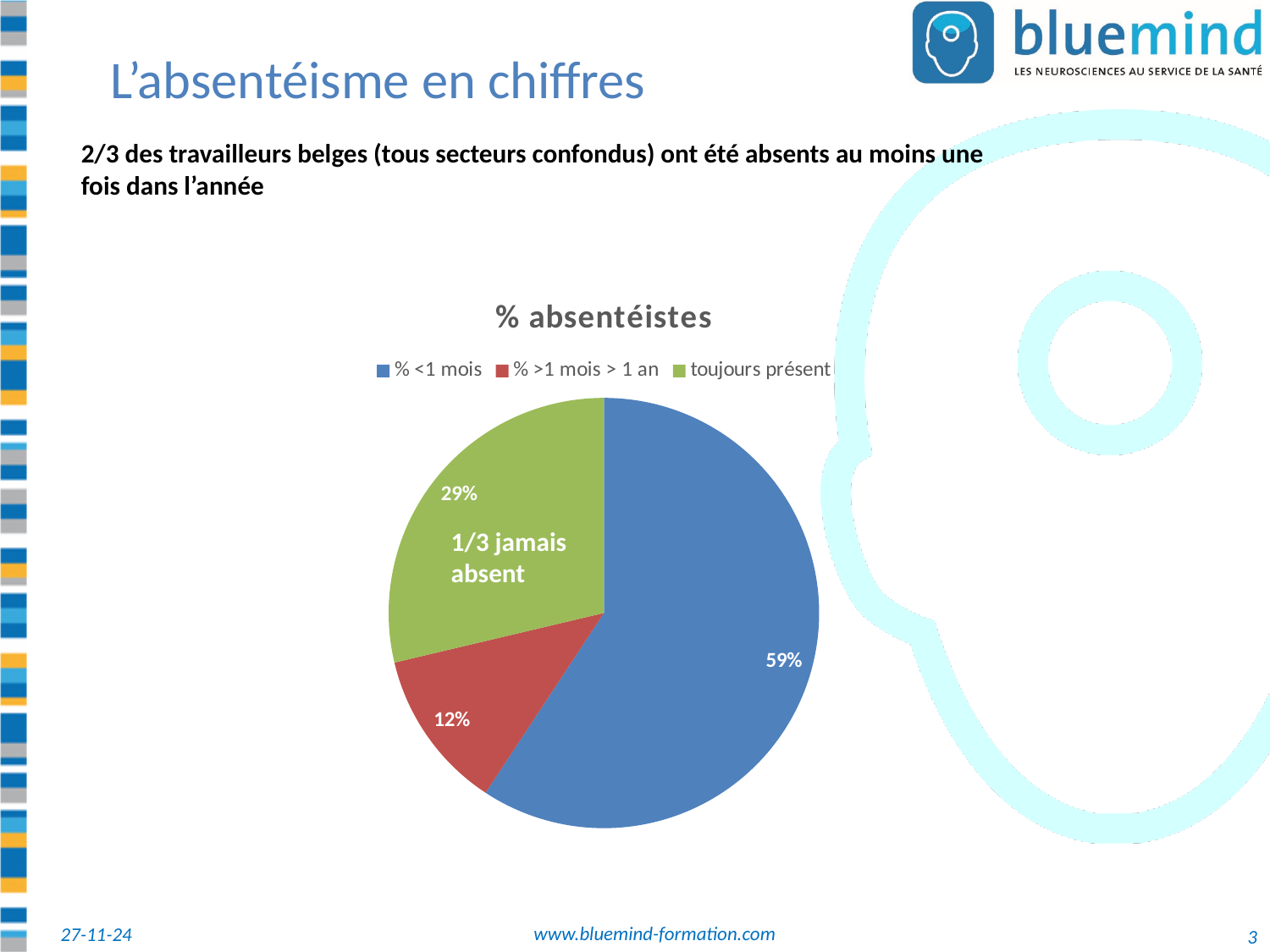
What is the title of the chart? % absentéistes What share of the pie does the "% >1 mois > 1 an" slice represent? 12% What share of the pie does the "toujours présent" slice represent? 29% How many entries does the legend list? 3 Which is larger, the "toujours présent" slice or the "% >1 mois > 1 an" slice? toujours présent What kind of chart is shown on the slide? pie chart How many slices does the pie chart have? 3 Which category has the smallest slice of the pie? % >1 mois > 1 an Which category has the largest slice of the pie? % <1 mois What share of the pie does the "% <1 mois" slice represent? 59% What is the difference between the "% <1 mois" share and the "toujours présent" share? 30% What colour is the "toujours présent" slice? green